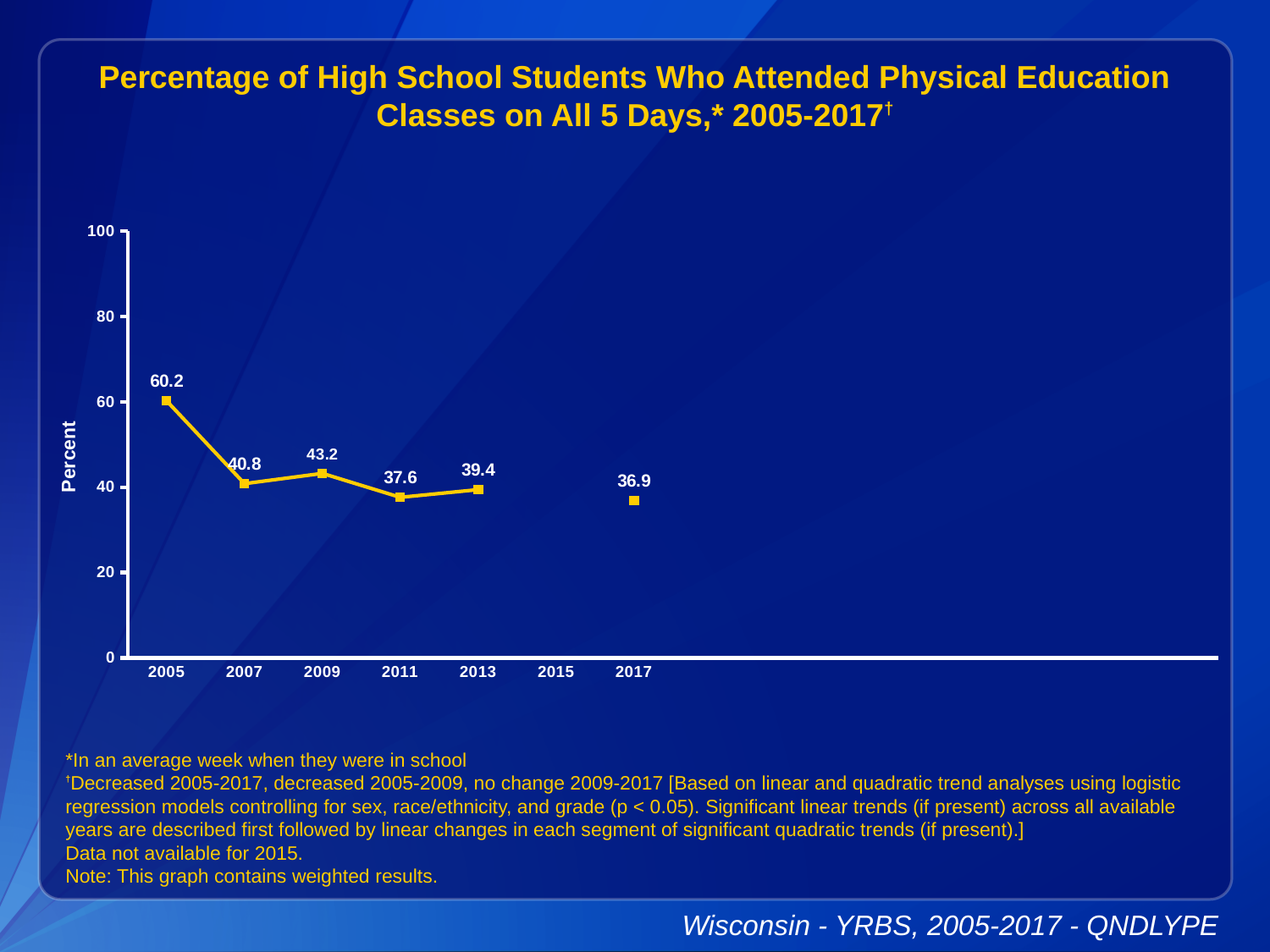
What is the value plotted for 2017? 36.9 Which year has the lowest value on the chart? 2017 Is the value for 2013 greater or less than 60? less What is the difference between the 2005 value and the 2007 value? 19.4 What percentage of high school students attended physical education classes on all 5 days in 2005? 60.2 What kind of chart is shown on the slide? line chart How many years have data points plotted on the chart? 6 What is the value plotted for 2011? 37.6 Which year has a larger value, 2009 or 2013? 2009 Which year has the highest value on the chart? 2005 Does the value rise or fall from 2005 to 2017? fall What is the label on the y axis? Percent